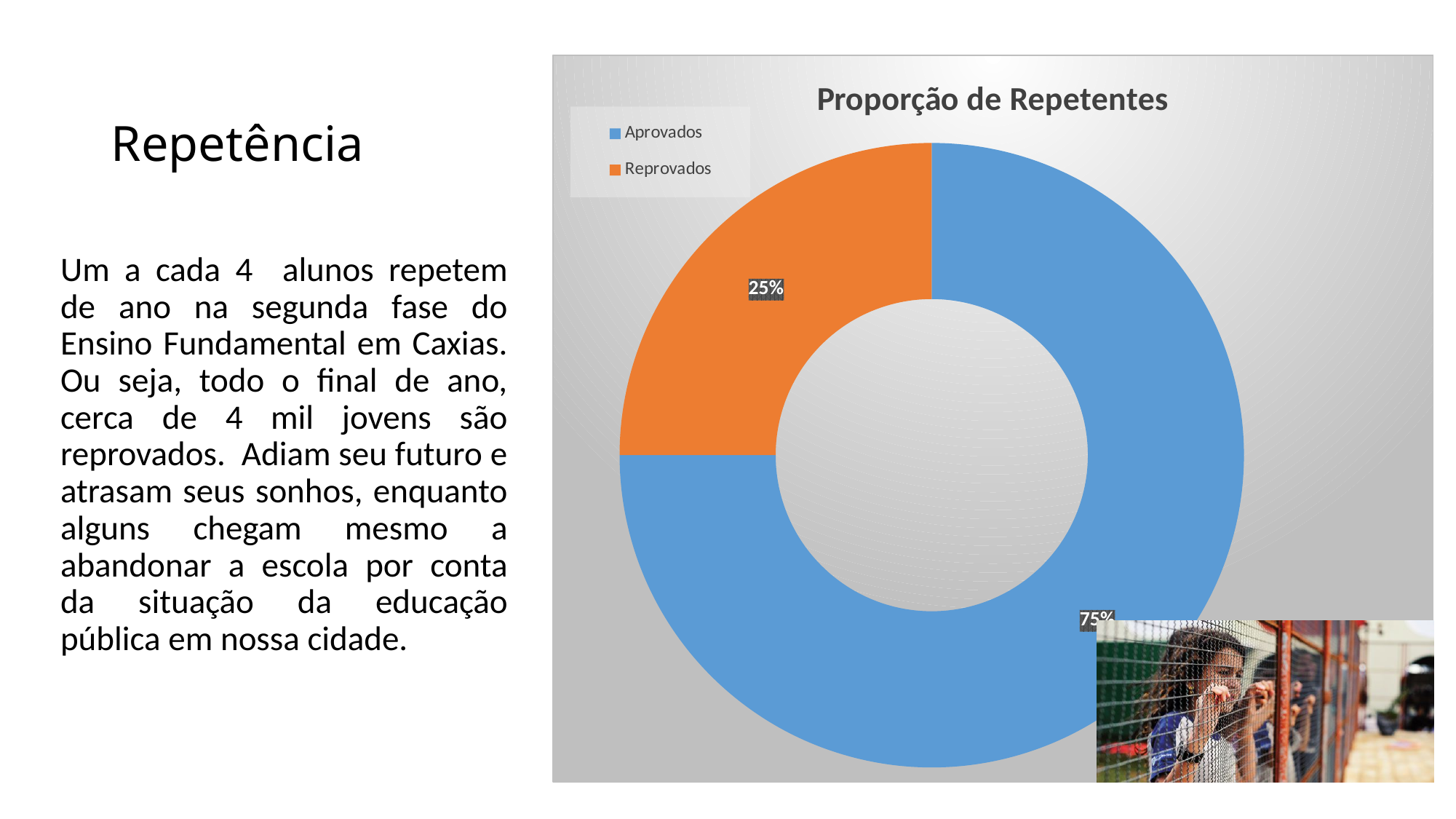
What share of the whole does the Reprovados slice represent? 25% What kind of chart is shown on the slide? Doughnut (pie) chart What is the title of the chart? Proporção de Repetentes What is the difference in percentage points between Aprovados and Reprovados? 50 percentage points Which category has the largest share of the chart? Aprovados Which is larger, the share for Aprovados or the share for Reprovados? Aprovados What colour represents Reprovados in the chart? Orange What percentage of the chart is labelled Aprovados? 75% What percentage of the chart is labelled Reprovados? 25% Which category has the smallest share of the chart? Reprovados How many categories does the legend list? 2